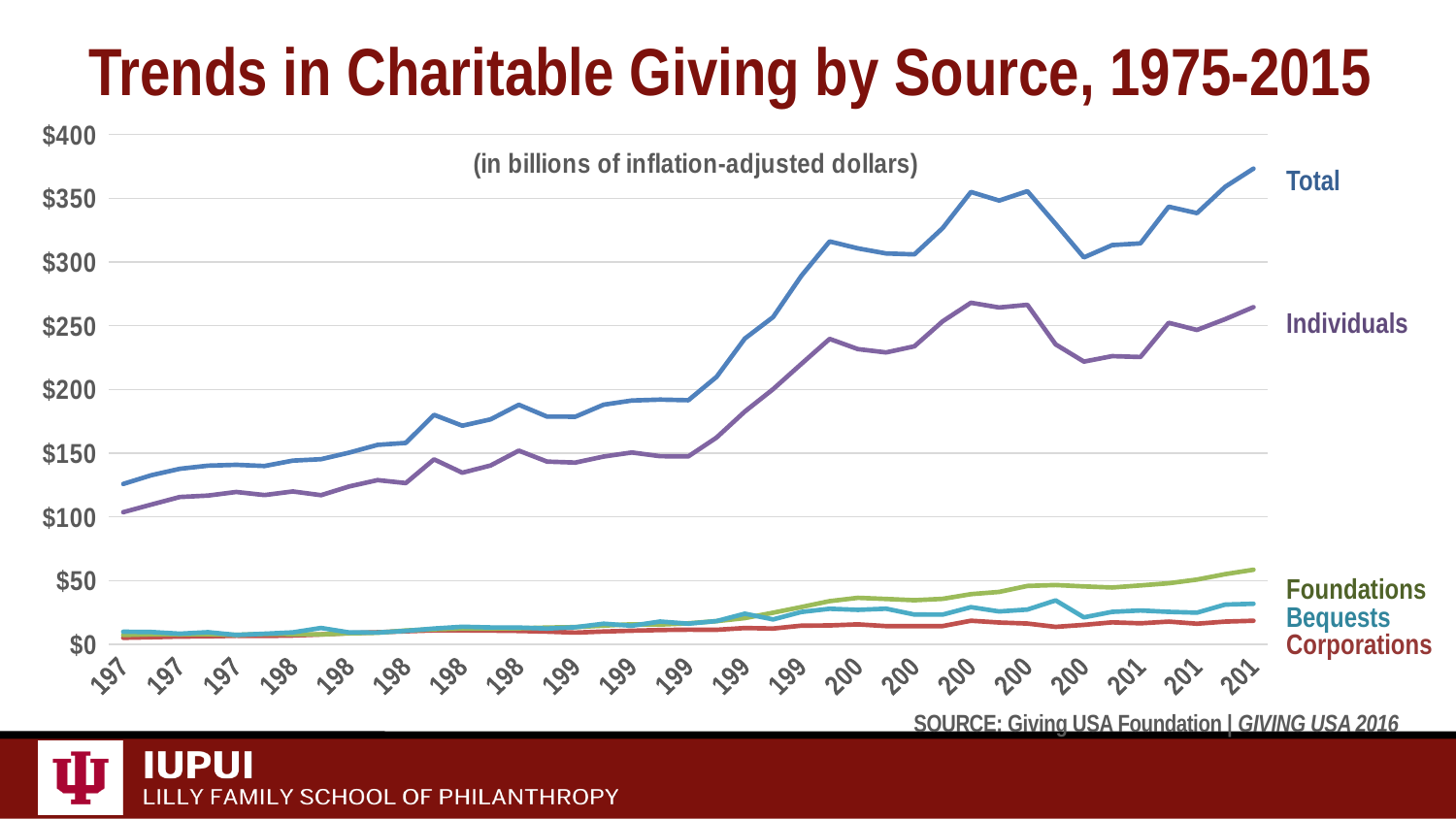
Which series has the lowest values at the right end of the chart? Corporations At the right end of the chart (2015), is the value for Total greater or less than $350? greater In what units are the values on the chart expressed, according to the subtitle? billions of inflation-adjusted dollars At the right end of the chart (2015), is the value for Corporations greater or less than $50? less At the right end of the chart (2015), is the value for Individuals greater or less than $250? greater How many series are plotted on the chart? 5 Which series is larger at the right end of the chart, Individuals or Foundations? Individuals Which series has the highest values throughout the chart? Total Does the Total series generally rise or fall from left to right across the chart? rise What kind of chart is shown on the slide? line chart